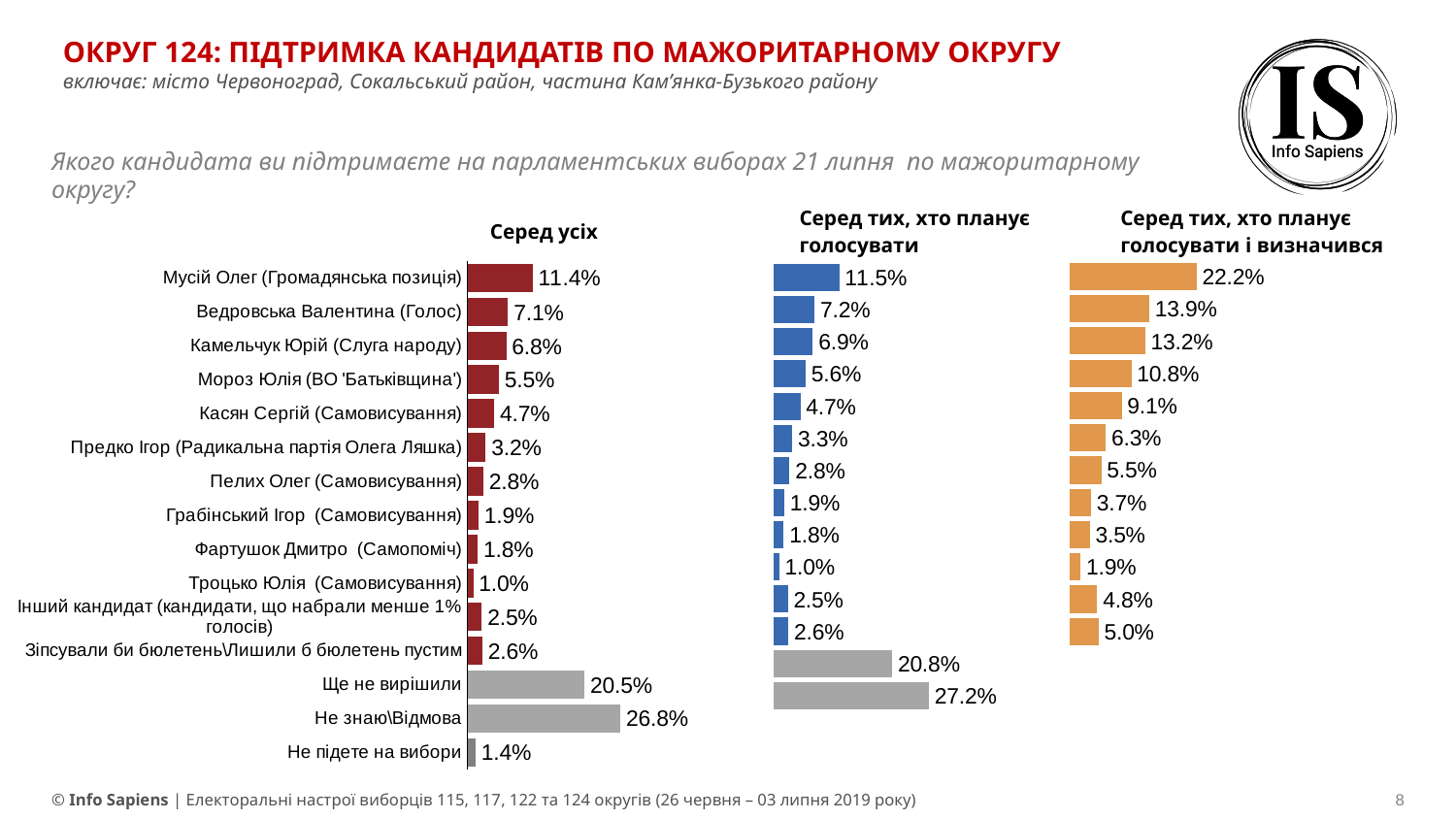
How many bars are shown in the chart 'Серед усіх'? 15 What colour are the bars for the candidates in the chart 'Серед тих, хто планує голосувати'? Blue In the chart 'Серед тих, хто планує голосувати і визначився', what is the value for Ведровська Валентина (Голос)? 13.9% How many bars are shown in the chart 'Серед тих, хто планує голосувати і визначився'? 12 In the chart 'Серед усіх', which category has the highest value? Не знаю\Відмова In the chart 'Серед тих, хто планує голосувати і визначився', which candidate has the lowest value? Троцько Юлія (Самовисування) In the chart 'Серед усіх', what is the value for Мусій Олег (Громадянська позиція)? 11.4% In the chart 'Серед тих, хто планує голосувати', what is the difference between 'Не знаю\Відмова' (27.2%) and 'Ще не вирішили' (20.8%)? 6.4% In the chart 'Серед усіх', which is larger: the value for Ведровська Валентина (Голос) or for Камельчук Юрій (Слуга народу)? Ведровська Валентина (Голос) In the chart 'Серед тих, хто планує голосувати', what is the value for 'Не знаю\Відмова'? 27.2% In the chart 'Серед тих, хто планує голосувати і визначився', what is the difference between Мусій Олег (22.2%) and Камельчук Юрій (13.2%)? 9.0% What type of chart is 'Серед усіх'? Bar chart